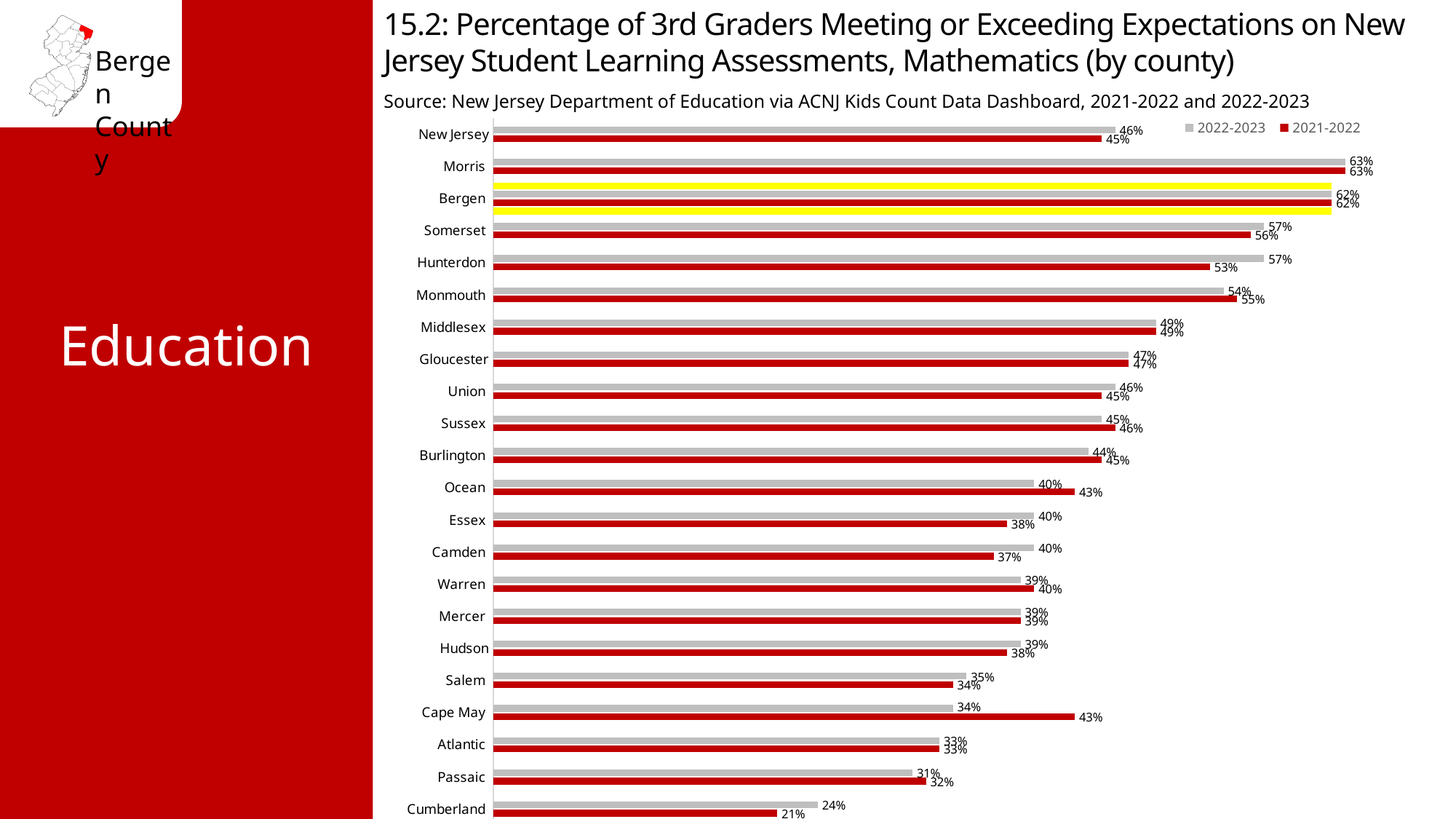
What is the difference between Cape May's 2021-2022 and 2022-2023 values? 9 percentage points What type of chart is shown on the slide? Bar chart How many counties or regions are listed on the chart? 22 What was the 2022-2023 value for Hunterdon? 57% Which is larger for Cumberland: the 2022-2023 value or the 2021-2022 value? 2022-2023 Which county has the highest 2022-2023 value? Morris Which is larger for Ocean: the 2022-2023 value or the 2021-2022 value? 2021-2022 How many series does the legend list? 2 What was the 2021-2022 value for Cape May? 43% Which county has the lowest 2021-2022 value? Cumberland What percentage of 3rd graders in Bergen met or exceeded expectations in 2022-2023? 62% What is the difference between Hunterdon's 2022-2023 and 2021-2022 values? 4 percentage points